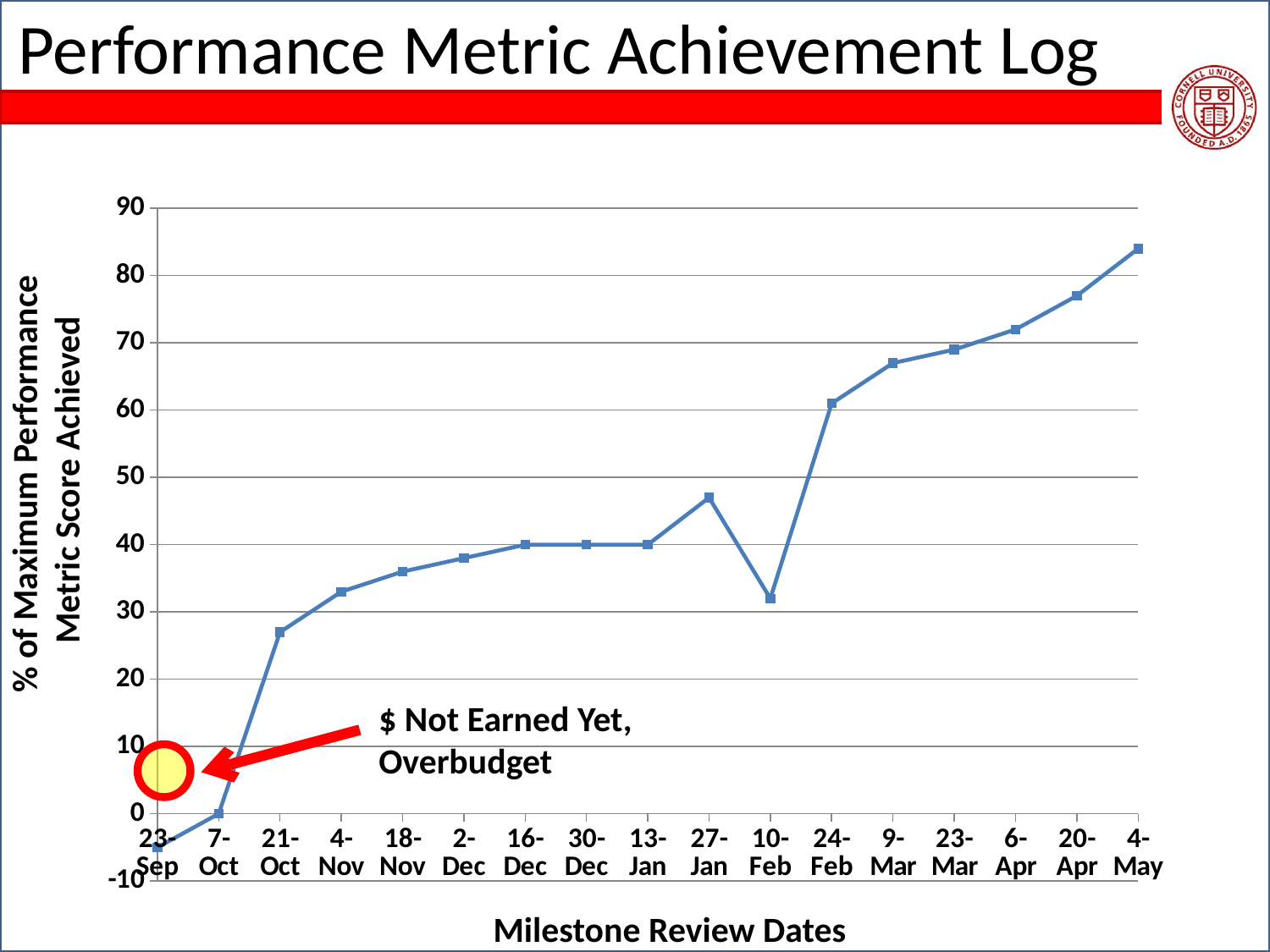
What is the % of maximum performance metric score achieved on 7-Oct? 0 Which is larger, the value for 27-Jan or the value for 10-Feb? 27-Jan Is the value for 24-Feb greater or less than 50? greater What is the % of maximum performance metric score achieved on 16-Dec? 40 Overall, do the values rise or fall from 23-Sep to 4-May? rise How many milestone review dates are plotted on the x axis? 17 What kind of chart is shown on the slide? line chart Is the value for 10-Feb greater or less than 40? less Which milestone review date has the lowest % of maximum performance metric score achieved? 23-Sep What is the title of the x axis? Milestone Review Dates Which milestone review date has the highest % of maximum performance metric score achieved? 4-May Is the value for 4-May greater or less than 80? greater